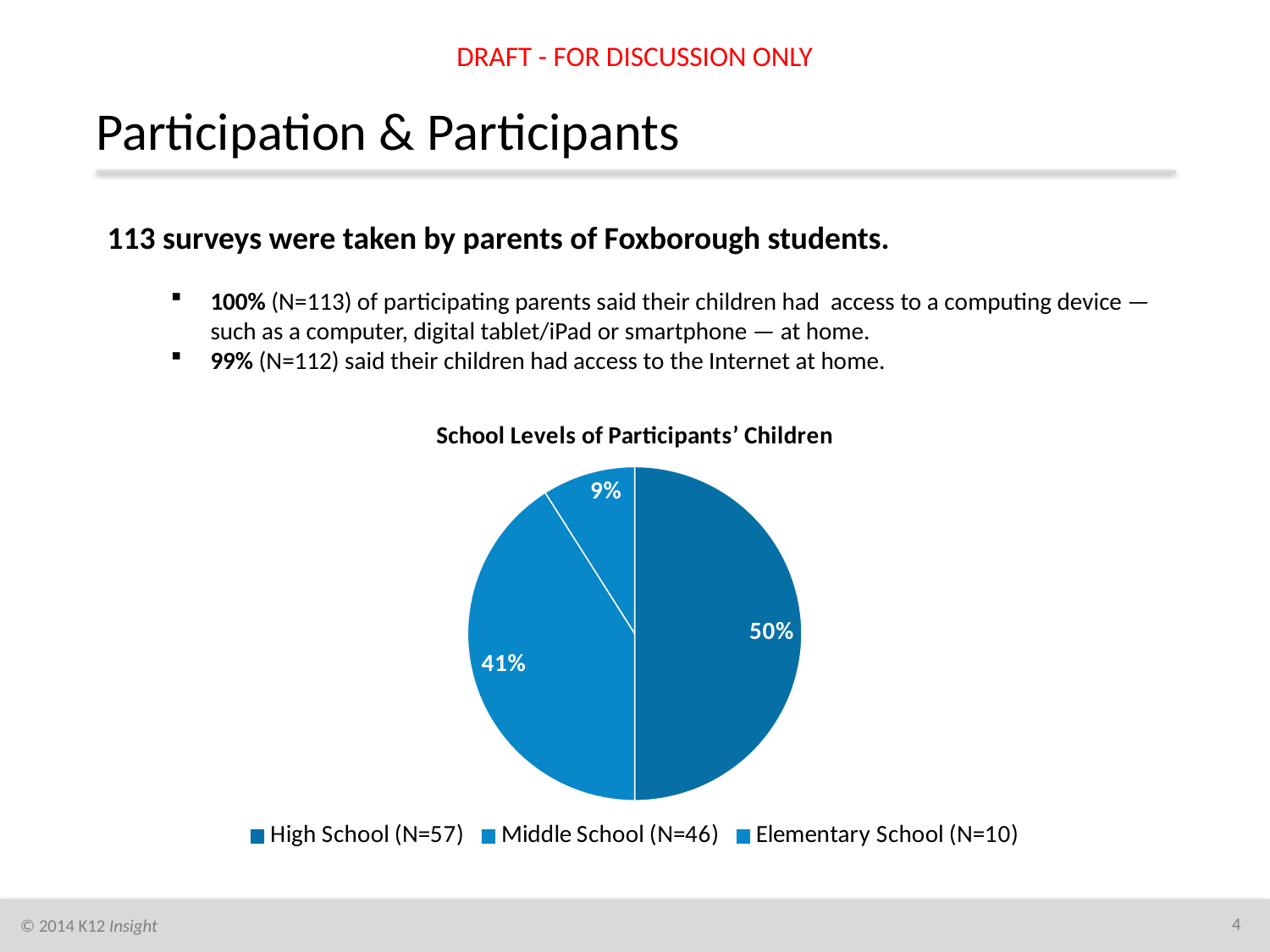
Which school level has the largest slice of the pie? High School (N=57) What share of the pie is Elementary School (N=10)? 9% What share of the pie is High School (N=57)? 50% Which slice is larger, Middle School or Elementary School? Middle School What is the difference in percentage points between the High School and Middle School slices? 9 What type of chart is shown on the slide? Pie chart How many entries does the legend list? 3 What is the difference in percentage points between the Middle School and Elementary School slices? 32 How many slices does the pie chart have? 3 What is the title of the chart? School Levels of Participants' Children Which school level has the smallest slice of the pie? Elementary School (N=10) What share of the pie is Middle School (N=46)? 41%